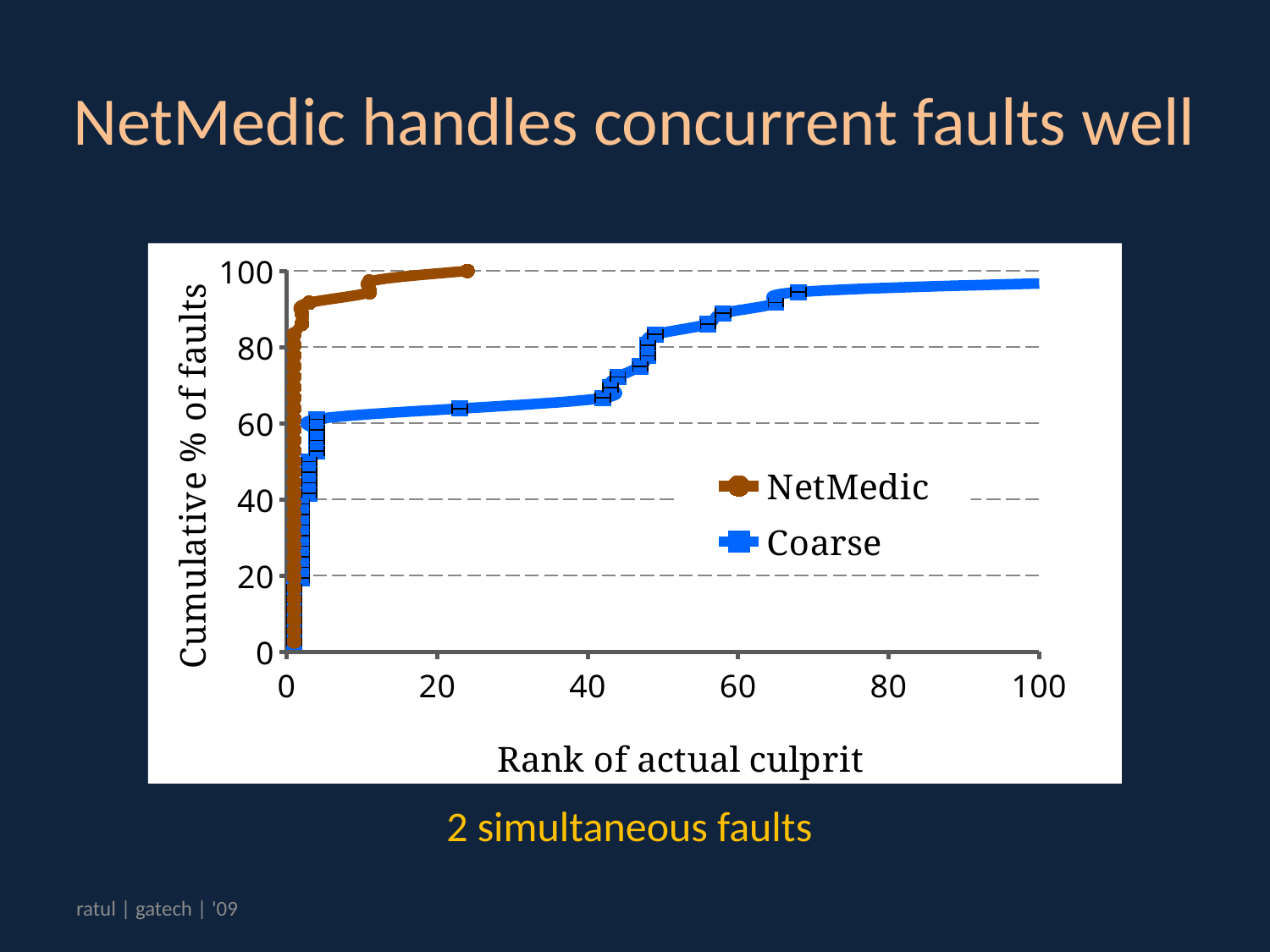
At a rank of 20, which series has the higher cumulative % of faults, NetMedic or Coarse? NetMedic At a rank of 40, is the cumulative % of faults for Coarse greater or less than 80? less What kind of chart is shown on the slide? line chart At a rank of 10, is the cumulative % of faults for NetMedic greater or less than 80? greater Which series reaches 100% cumulative faults at a lower rank, NetMedic or Coarse? NetMedic At a rank of 20, is the cumulative % of faults for Coarse greater or less than 80? less How many series does the legend list? 2 Does the Coarse series rise or fall as the rank of actual culprit increases? rise What are the two series named in the legend? NetMedic and Coarse What is the label of the x axis? Rank of actual culprit